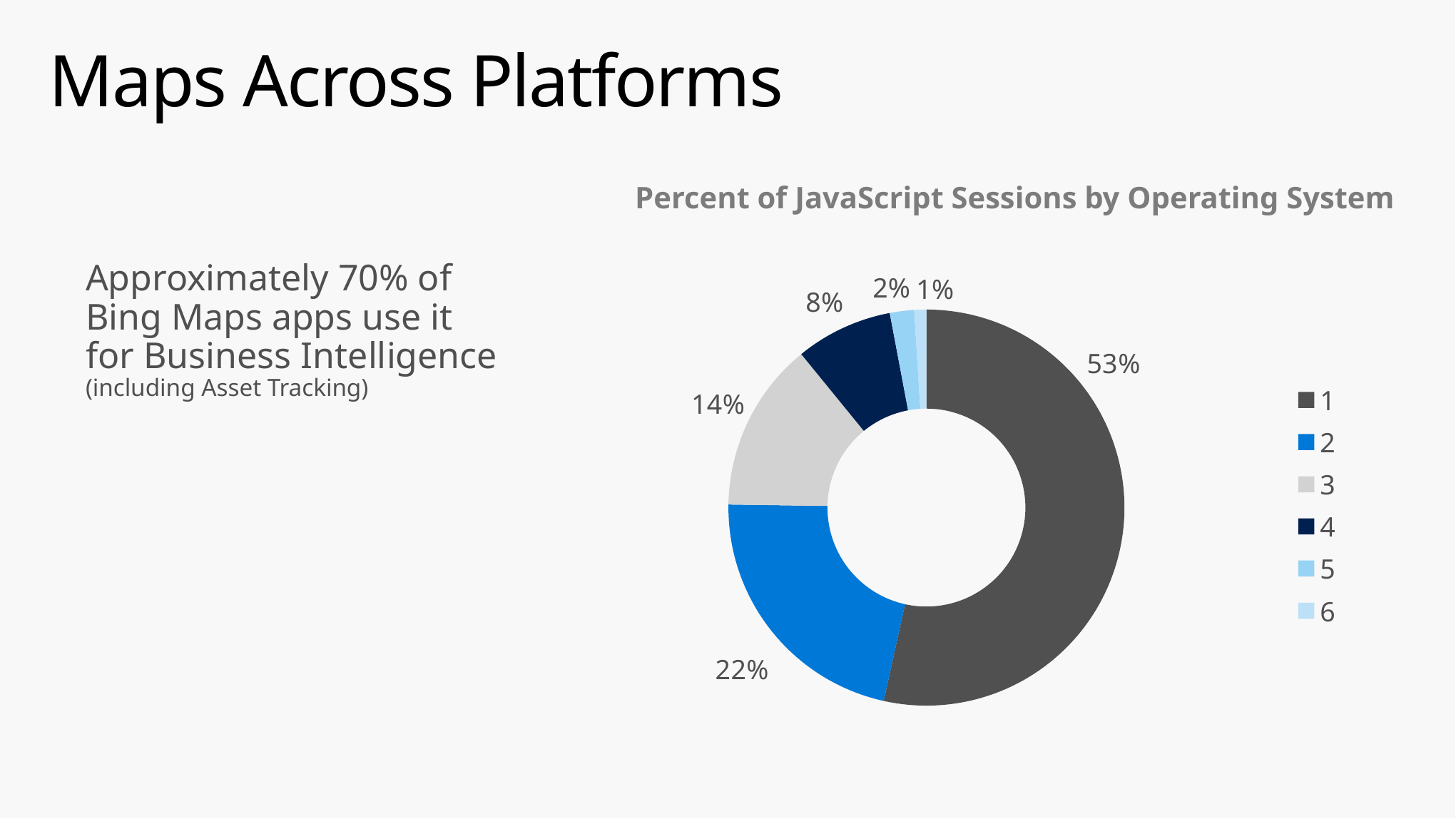
What percentage is shown for category 4? 8% What is the difference in percentage points between category 1 and category 2? 31 How many categories does the legend list? 6 What kind of chart is shown on the slide? Doughnut (pie) chart What percentage is shown for category 3? 14% Which is larger, the share for category 3 or the share for category 4? 3 What colour is the slice for category 2? Blue What percentage is shown for category 2? 22% What is the title of the chart? Percent of JavaScript Sessions by Operating System Which category has the smallest share of the chart? 6 Which category has the largest share of the chart? 1 What percentage is shown for category 1? 53%